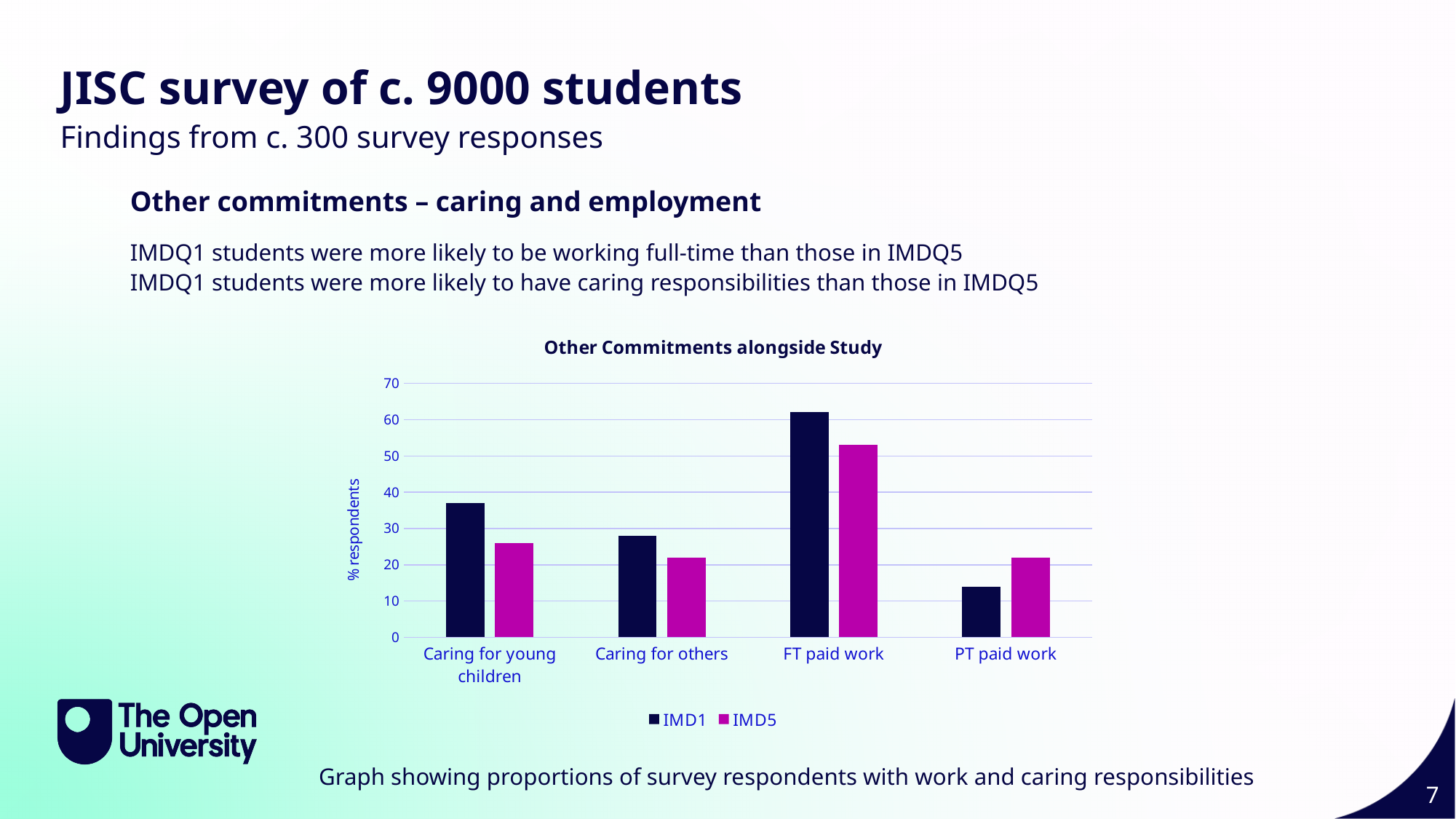
How many series does the chart's legend list? 2 Which category has the highest value for IMD5? FT paid work What kind of chart is shown on the slide? bar chart What is the label on the vertical axis of the chart? % respondents How many categories are shown on the x axis of the chart? 4 Which category has the highest value for IMD1? FT paid work For Caring for young children, which series has the larger value, IMD1 or IMD5? IMD1 What is the title of the chart? Other Commitments alongside Study Is the IMD5 value for Caring for young children greater or less than 30? less For PT paid work, which series has the larger value, IMD1 or IMD5? IMD5 Which category has the lowest value for IMD1? PT paid work Is the IMD1 value for FT paid work greater or less than 60? greater